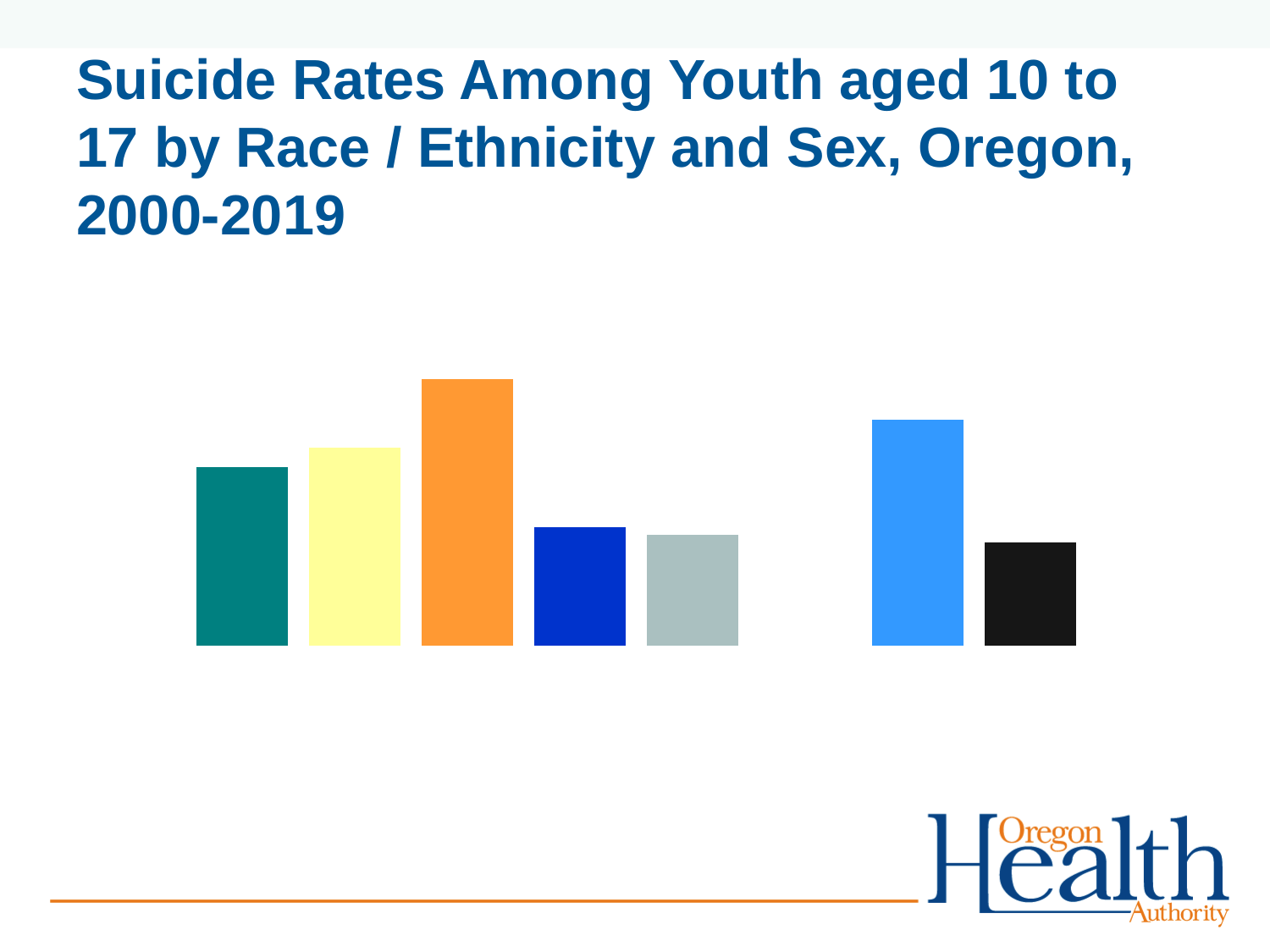
Which is taller, the teal bar or the yellow bar? the yellow bar Which coloured bar is the shortest in the chart? the black bar Which is taller, the light blue bar or the orange bar? the orange bar How many bars are plotted in the chart? 7 Which is taller, the light blue bar or the black bar? the light blue bar Which coloured bar is the tallest in the chart? the orange bar What kind of chart is shown on the slide? bar chart What colour is the tallest bar in the chart? orange What is the title of the slide containing the chart? Suicide Rates Among Youth aged 10 to 17 by Race / Ethnicity and Sex, Oregon, 2000-2019